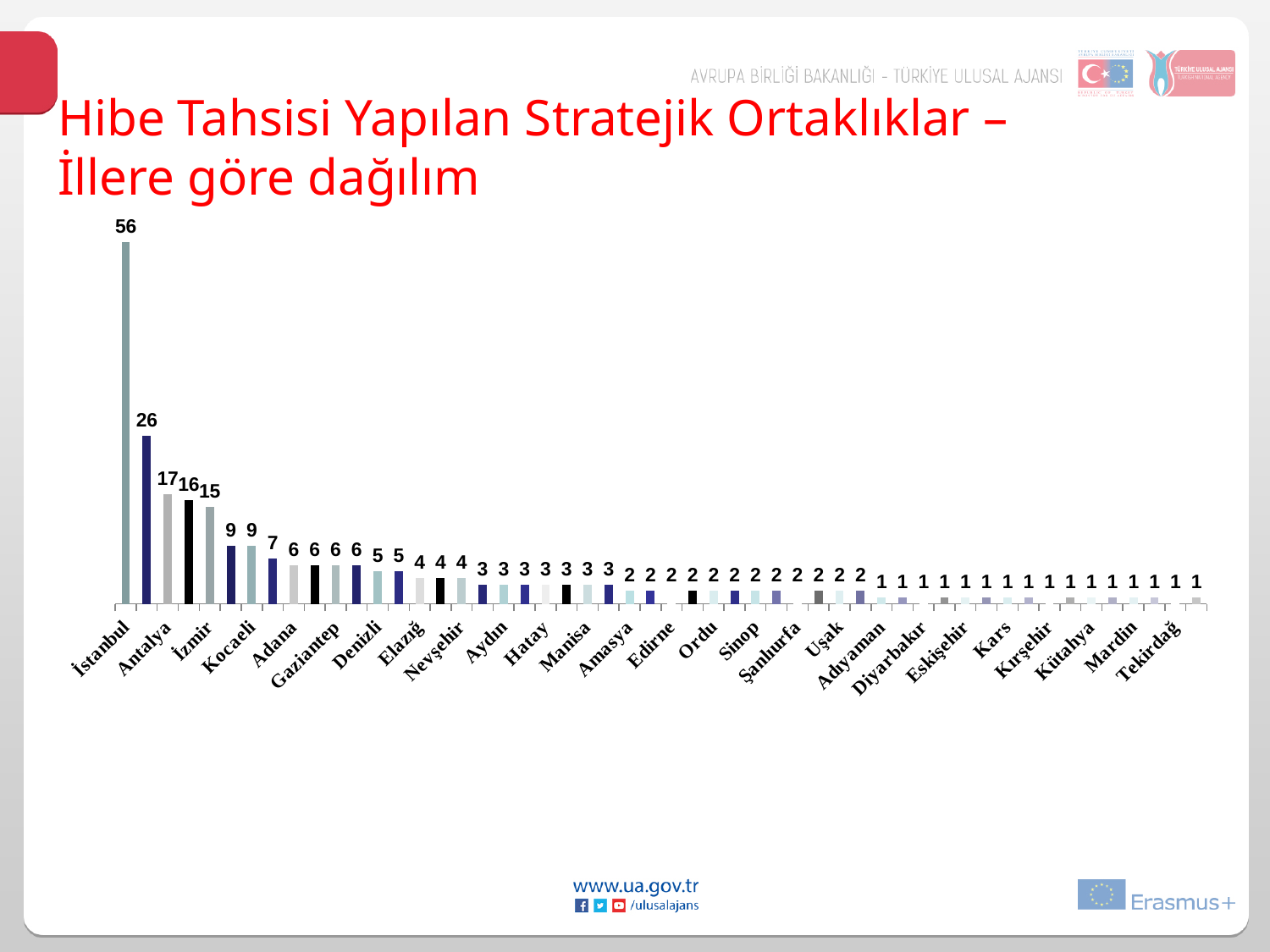
What is the lowest value shown on any bar in the chart? 1 Which province has the highest value in the chart? İstanbul What is the value for Mardin? 1 What is the value for Tekirdağ? 1 What is the difference between the highest value (56) and the second-highest value (26)? 30 What is the second-highest value shown in the chart? 26 What is the value for Kars? 1 What is the title of the slide containing the chart? Hibe Tahsisi Yapılan Stratejik Ortaklıklar – İllere göre dağılım Which is larger, the value for İstanbul or the value for Antalya? İstanbul Do the values generally rise or fall moving from left to right along the x axis? Fall What is the value for İstanbul? 56 What kind of chart is shown on the slide? Bar chart